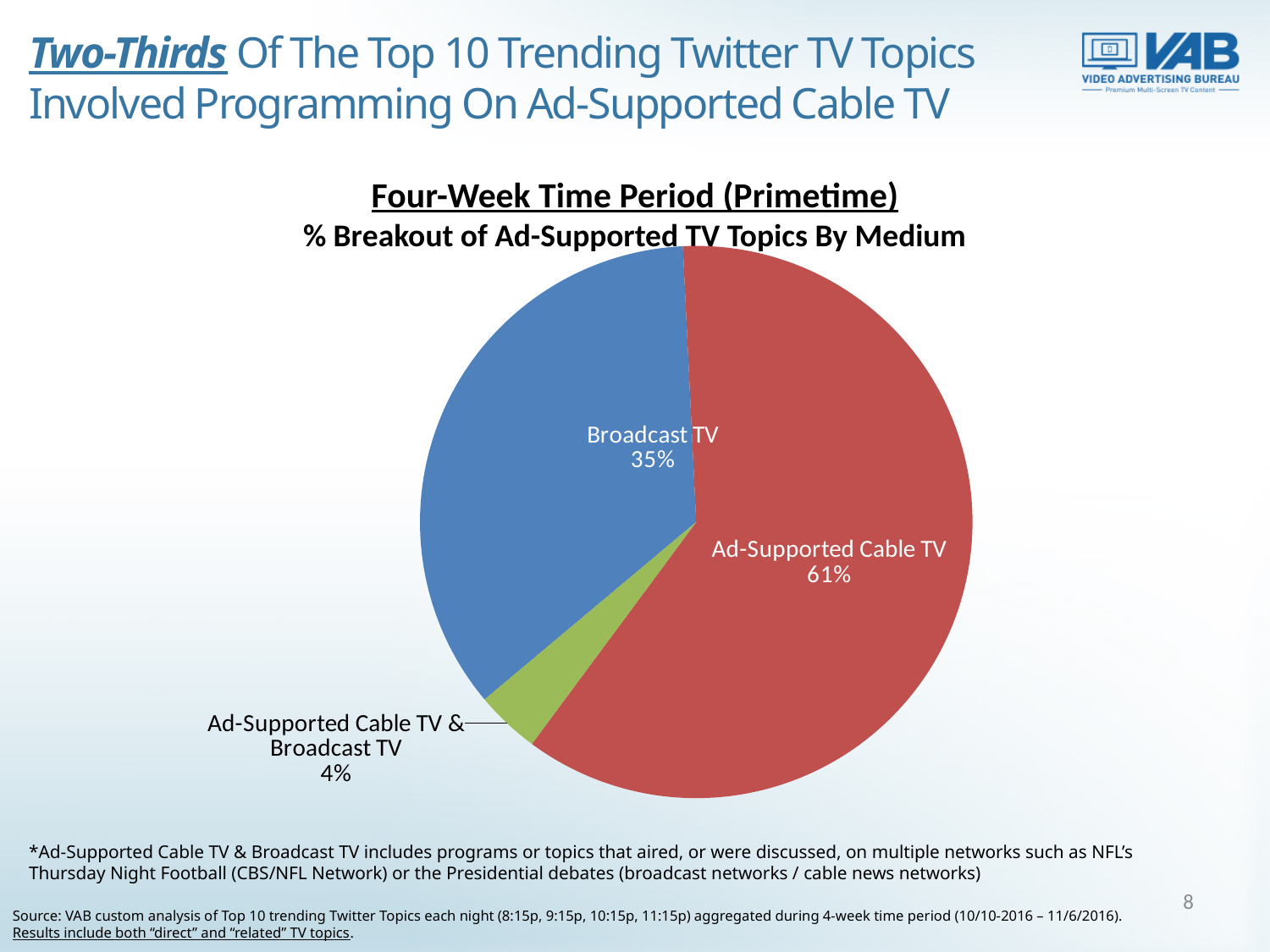
What is the difference in percentage points between the Ad-Supported Cable TV share and the Broadcast TV share? 26 What colour is the Ad-Supported Cable TV slice? red What kind of chart is shown on the slide? pie chart Which medium has the smallest share of the pie? Ad-Supported Cable TV & Broadcast TV What share of ad-supported TV topics is attributed to Broadcast TV? 35% What share of ad-supported TV topics is attributed to Ad-Supported Cable TV? 61% Which is larger, the share for Broadcast TV or the share for Ad-Supported Cable TV & Broadcast TV? Broadcast TV Which medium has the largest share of the pie? Ad-Supported Cable TV What is the combined share of Broadcast TV and Ad-Supported Cable TV & Broadcast TV? 39% What is the subtitle of the chart, shown below 'Four-Week Time Period (Primetime)'? % Breakout of Ad-Supported TV Topics By Medium How many slices does the pie chart have? 3 What share of ad-supported TV topics is attributed to Ad-Supported Cable TV & Broadcast TV? 4%